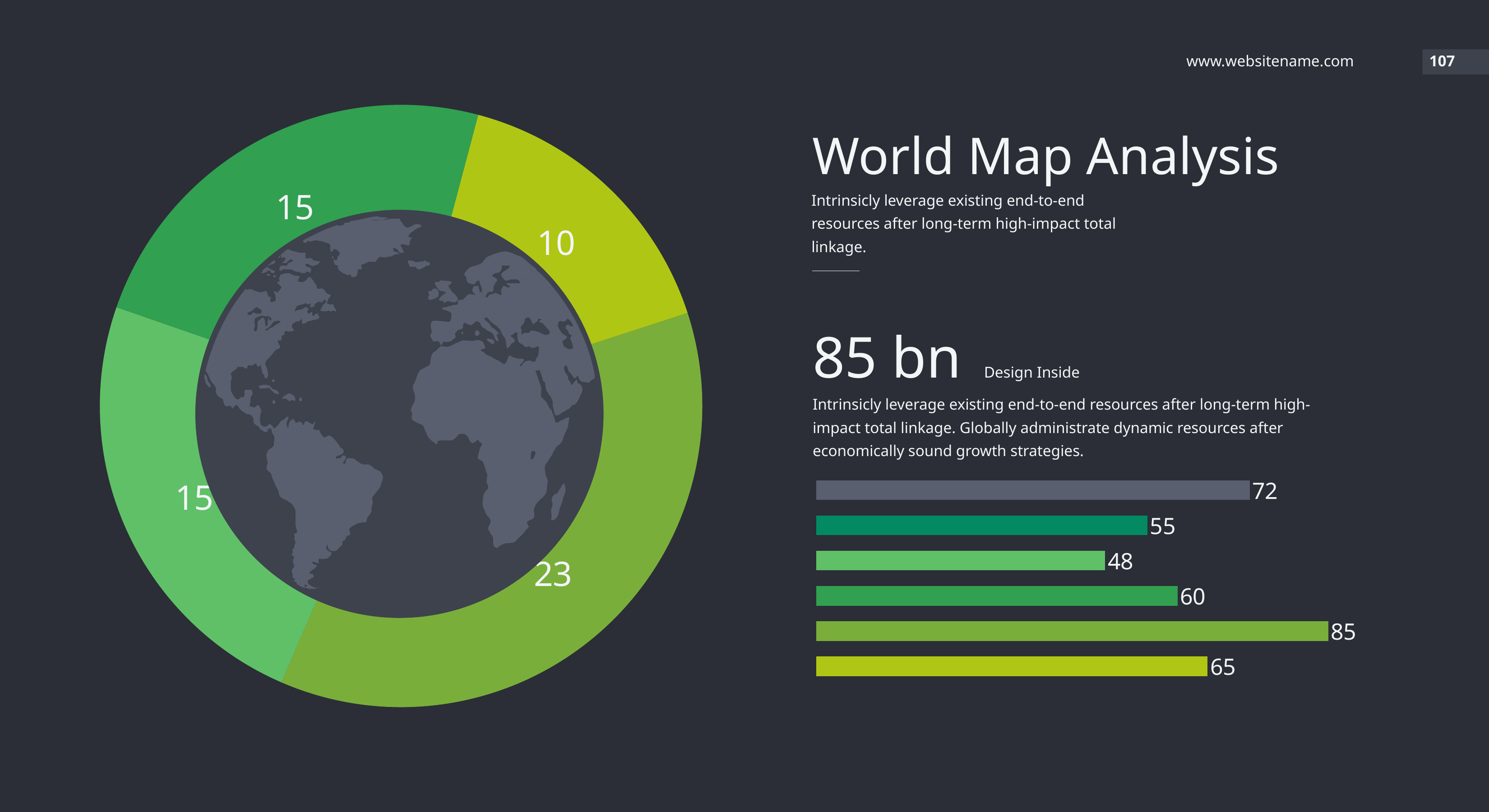
In the donut chart on the left, what is the difference between the largest slice (23) and the smallest slice (10)? 13 In the donut chart on the left, what is the total of all slice values? 63 In the bar chart on the right, what is the lowest bar value? 48 In the bar chart on the right, what is the value of the topmost (grey) bar? 72 What kind of chart is on the right side of the slide, below the text? bar chart In the bar chart on the right, what is the difference between the first bar (72) and the second bar (55)? 17 In the donut chart on the left, what is the largest slice value? 23 In the donut chart on the left, what is the smallest slice value? 10 In the bar chart on the right, what is the highest bar value? 85 How many bars does the bar chart on the right have? 6 How many slices does the donut chart on the left have? 4 What kind of chart is on the left side of the slide? donut chart